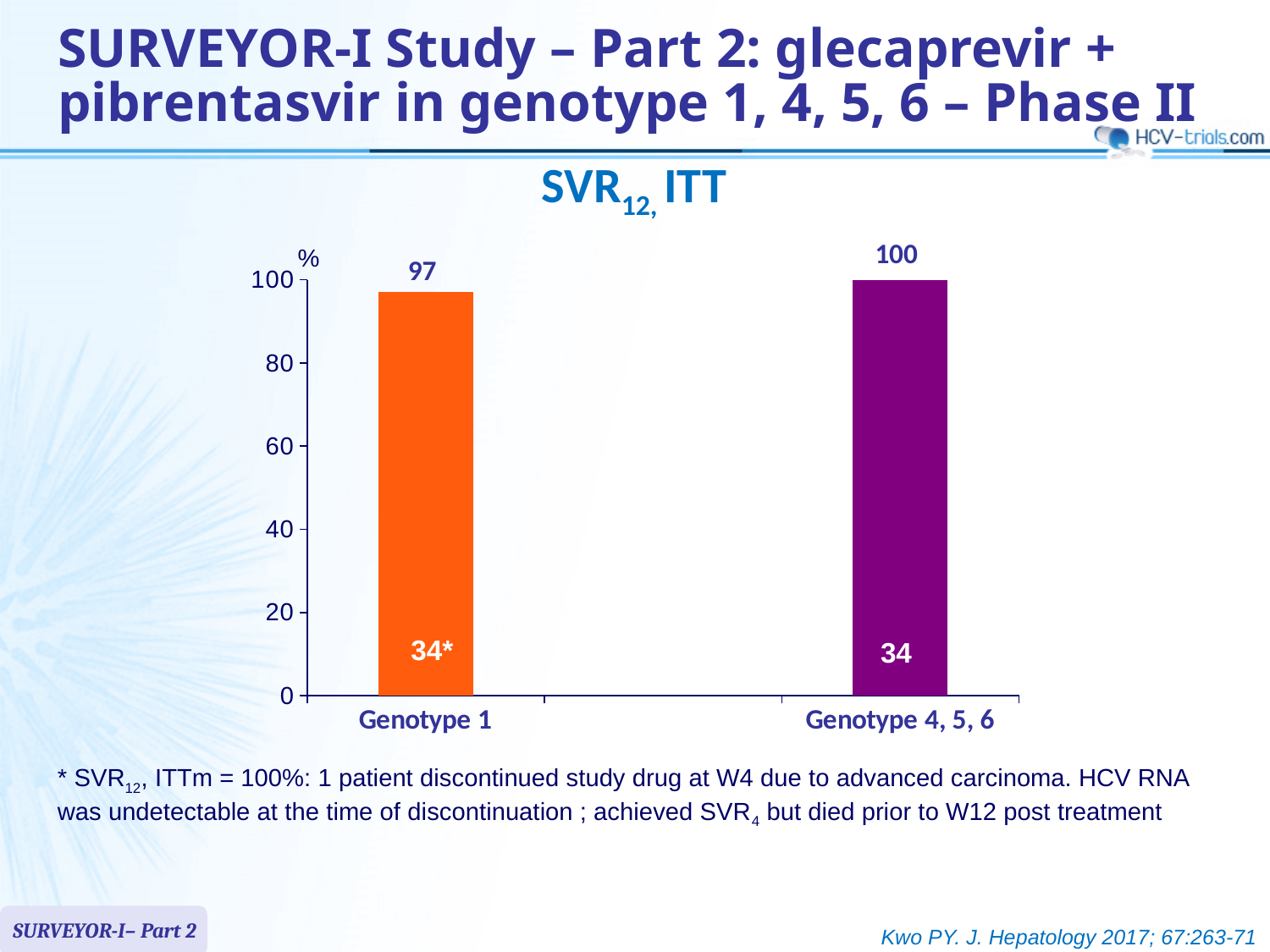
How many patients are in the Genotype 4, 5, 6 group, as labelled inside the bar? 34 What is the SVR12 value for Genotype 1? 97 How many patients are in the Genotype 1 group, as labelled inside the bar? 34 What is the title of the chart? SVR12, ITT Which genotype group has the lowest SVR12 value? Genotype 1 What colour is the bar for Genotype 4, 5, 6? Purple How many genotype groups are shown in the chart? 2 What is the difference in SVR12 between Genotype 4, 5, 6 and Genotype 1? 3 What is the SVR12 value for Genotype 4, 5, 6? 100 Is the SVR12 value for Genotype 1 greater or less than 80? greater Which genotype group has the highest SVR12 value? Genotype 4, 5, 6 What kind of chart is shown on the slide? Bar chart